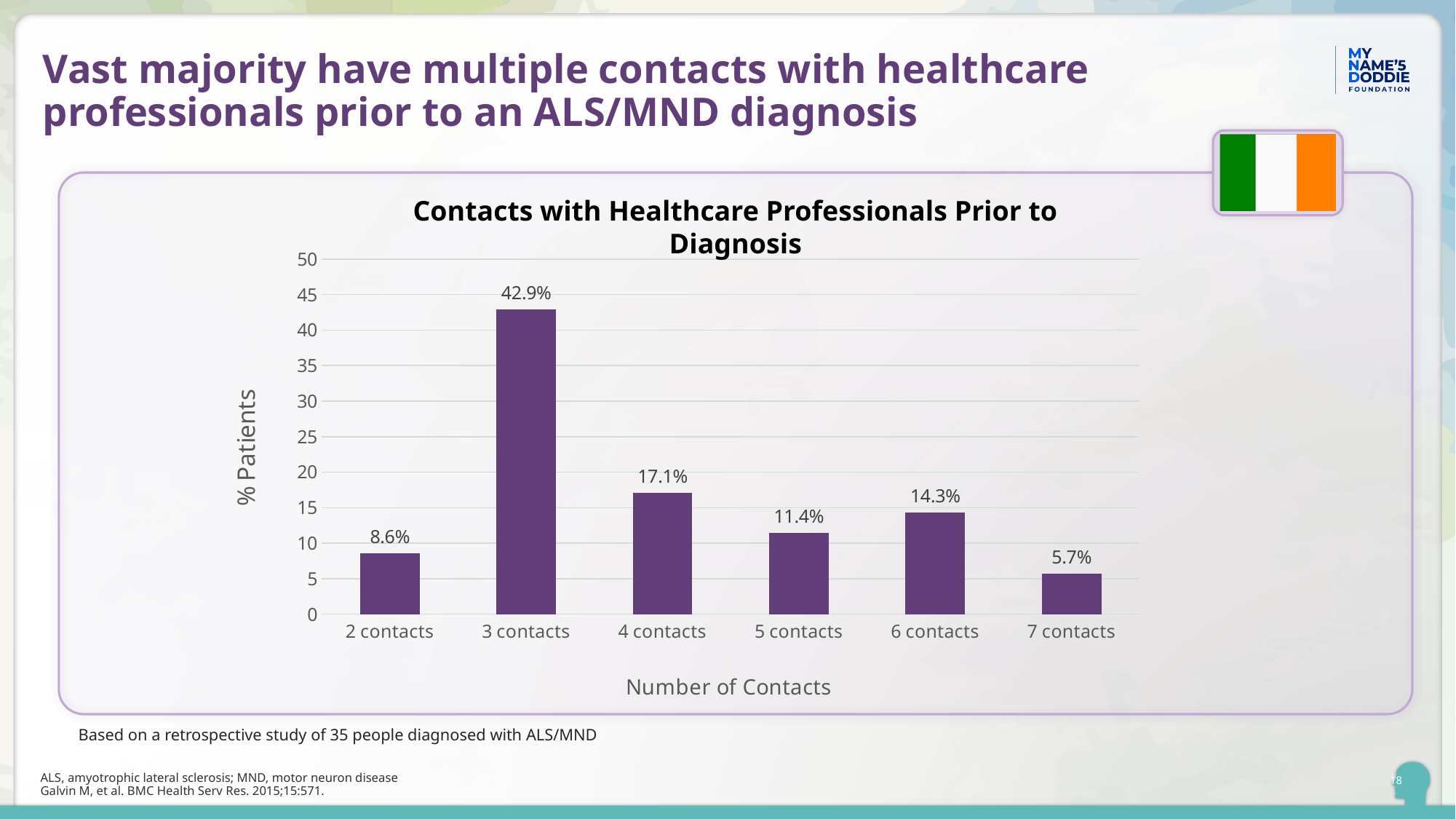
What kind of chart is shown on the slide? Bar chart What is the difference in percentage points between 4 contacts and 2 contacts? 8.5 Which number of contacts has the highest percentage of patients? 3 contacts What is the value shown for 5 contacts? 11.4% What percentage of patients had 7 contacts? 5.7% What percentage of patients had 3 contacts with healthcare professionals prior to diagnosis? 42.9% Which is larger, the value for 6 contacts or the value for 5 contacts? 6 contacts What is the title of the chart? Contacts with Healthcare Professionals Prior to Diagnosis Is the value for 3 contacts greater or less than 40? greater How many categories are shown on the x axis? 6 Which number of contacts has the lowest percentage of patients? 7 contacts What is the label of the y axis? % Patients